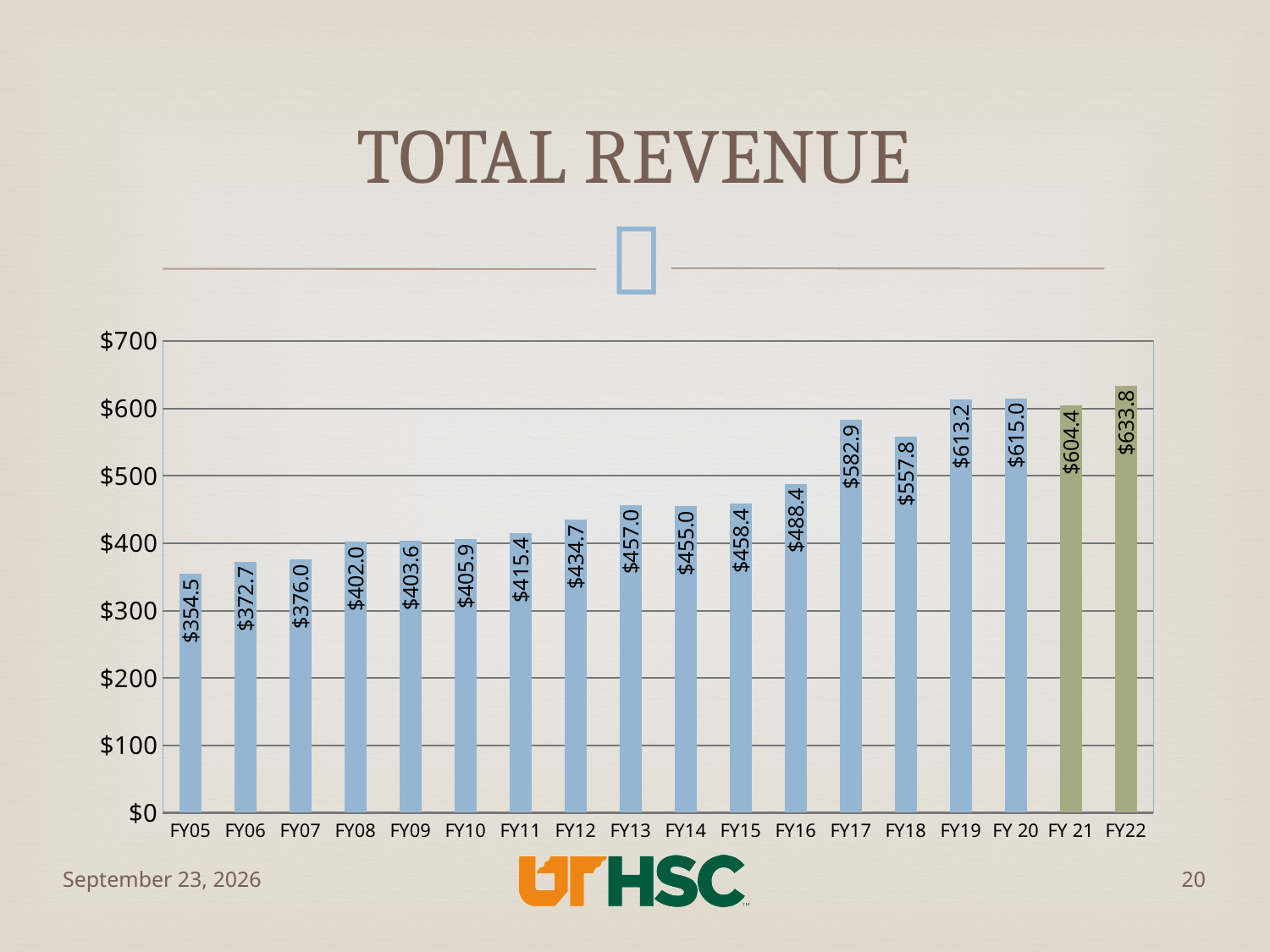
Is the total revenue for FY16 greater or less than $500? less Which fiscal year has the highest total revenue? FY22 How many fiscal years are shown on the chart? 18 What is the difference between the total revenue for FY22 and FY21? $29.4 Which fiscal year has the lowest total revenue? FY05 What kind of chart is shown on the slide? bar chart What is the total revenue value for FY22? $633.8 What is the total revenue value for FY05? $354.5 What is the difference between the total revenue for FY17 and FY16? $94.5 Which is larger, the total revenue for FY18 or FY19? FY19 What is the total revenue value for FY17? $582.9 Which bars are coloured green instead of blue? FY 21 and FY22